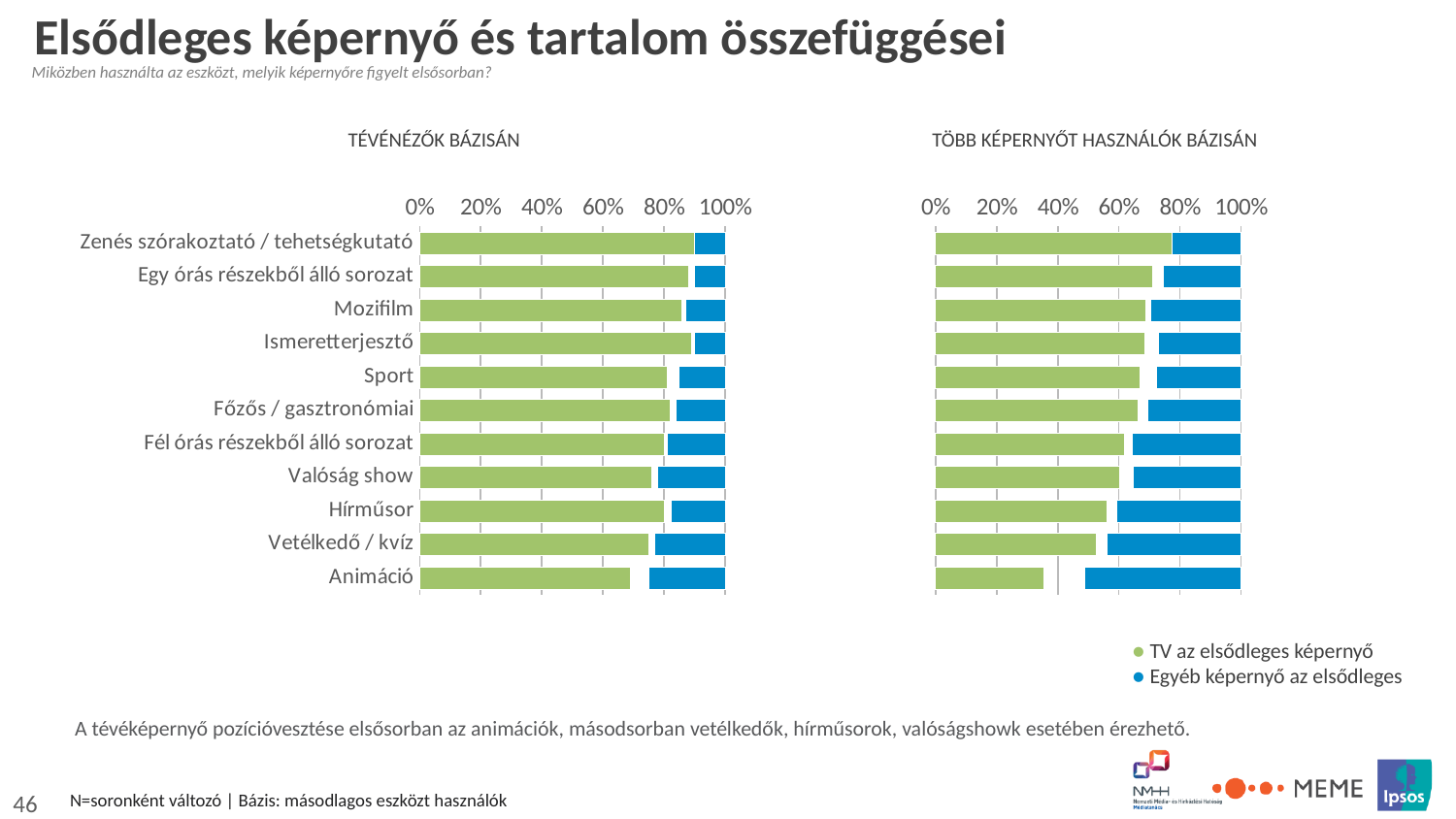
In the 'TÉVÉNÉZŐK BÁZISÁN' chart, is the 'TV az elsődleges képernyő' value for Animáció greater or less than 60%? greater In the 'TÉVÉNÉZŐK BÁZISÁN' chart, which has a larger 'TV az elsődleges képernyő' value: Zenés szórakoztató / tehetségkutató or Animáció? Zenés szórakoztató / tehetségkutató How many series does the legend list for the charts on this slide? 2 What kind of chart is the 'TÉVÉNÉZŐK BÁZISÁN' chart on the left? Stacked bar chart In the 'TÖBB KÉPERNYŐT HASZNÁLÓK BÁZISÁN' chart, is the 'TV az elsődleges képernyő' value for Animáció greater or less than 40%? less How many categories are plotted in the 'TÉVÉNÉZŐK BÁZISÁN' chart? 11 In the 'TÉVÉNÉZŐK BÁZISÁN' chart, is the 'TV az elsődleges képernyő' value for Zenés szórakoztató / tehetségkutató greater or less than 80%? greater Which series is shown in green in the charts on this slide? TV az elsődleges képernyő In the 'TÉVÉNÉZŐK BÁZISÁN' chart, which category has the lowest value for 'TV az elsődleges képernyő'? Animáció In the 'TÖBB KÉPERNYŐT HASZNÁLÓK BÁZISÁN' chart, which category has the lowest value for 'TV az elsődleges képernyő'? Animáció In the 'TÖBB KÉPERNYŐT HASZNÁLÓK BÁZISÁN' chart, which has a larger 'TV az elsődleges képernyő' value: Sport or Hírműsor? Sport In the 'TÖBB KÉPERNYŐT HASZNÁLÓK BÁZISÁN' chart, which category has the highest value for 'TV az elsődleges képernyő'? Zenés szórakoztató / tehetségkutató